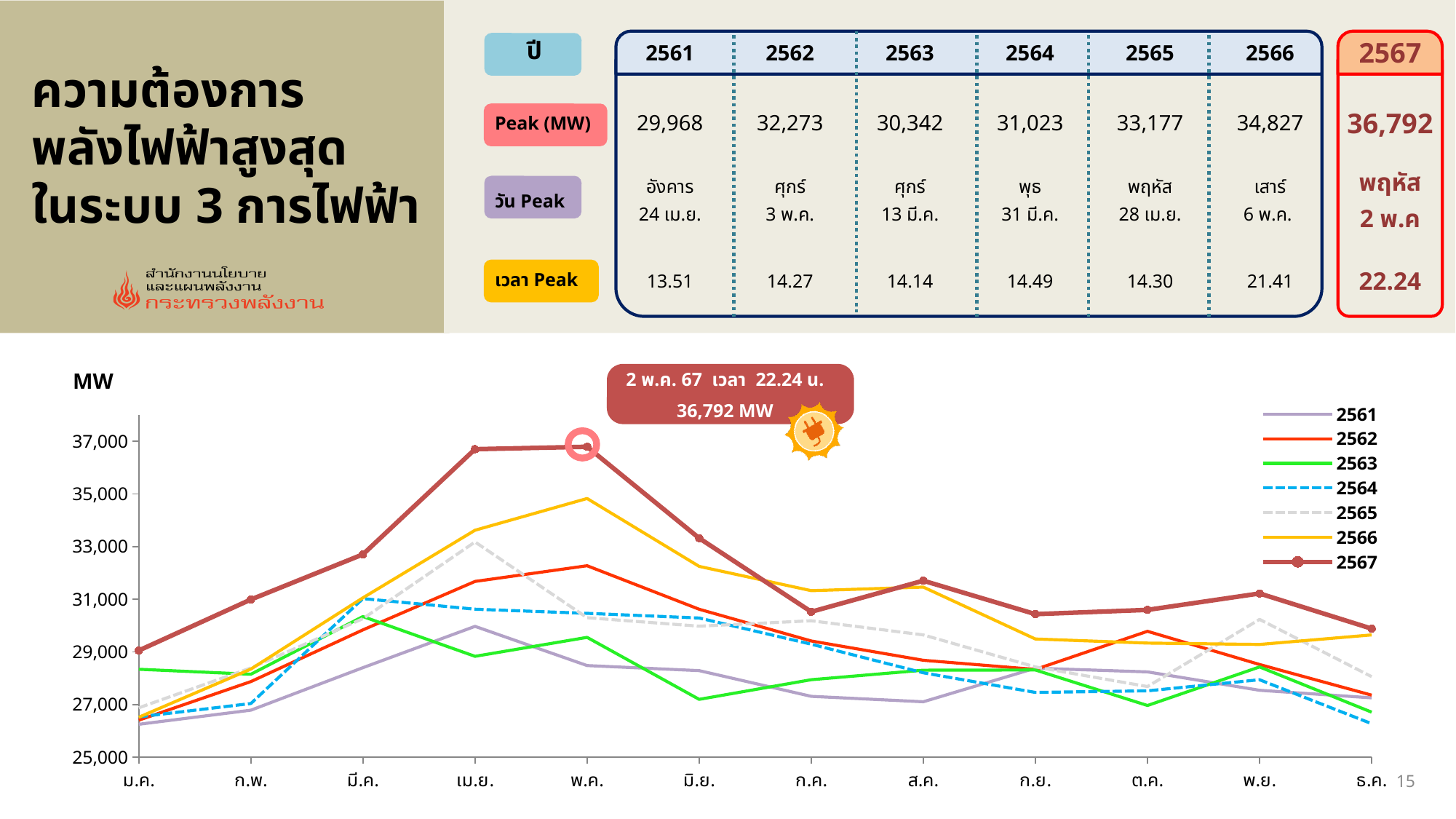
How many series does the chart legend list? 7 Does the 2567 series rise or fall from พ.ค. to ก.ค.? fall In เม.ย., which is larger: the value for 2567 or the value for 2561? 2567 Is the value for the 2567 series in มี.ค. greater or less than 31,000? greater What is the labelled value for the 2567 series in พ.ค.? 36,792 MW Which series has the highest value in เม.ย.? 2567 Is the value for the 2563 series in มิ.ย. greater or less than 28,000? less How many months are shown along the x axis of the chart? 12 What kind of chart is shown on the slide? line chart Which series is drawn as a dashed blue line in the legend? 2564 In which month does the 2567 series reach its highest value? พ.ค. Is the value for the 2566 series in พ.ค. greater or less than 33,000? greater